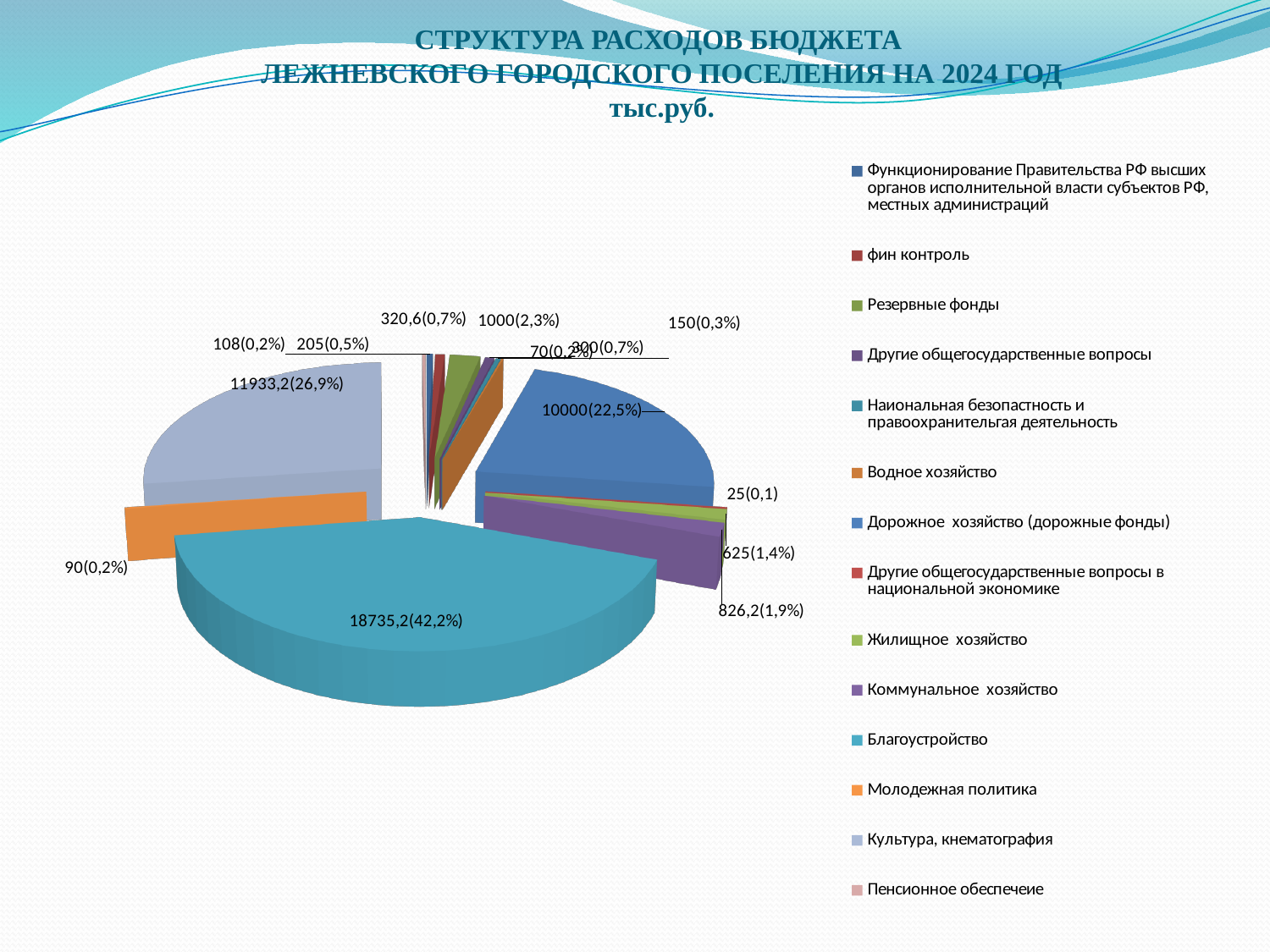
What is the smallest value labelled on the pie chart? 25(0,1) Which is larger: the slice for Культура, кнематография or the slice for Дорожное хозяйство (дорожные фонды)? Культура, кнематография Which category has the largest slice of the pie? Благоустройство What value is shown for Дорожное хозяйство (дорожные фонды)? 10000(22,5%) What is the value shown for the largest slice (Благоустройство)? 18735,2(42,2%) What value is shown for Культура, кнематография? 11933,2(26,9%) What is the difference between the Благоустройство value (18735,2) and the Культура, кнематография value (11933,2)? 6802 What kind of chart is shown on the slide? pie chart What share of the pie does Благоустройство take? 42,2% How many entries does the legend list? 14 What unit is stated in the chart title? тыс.руб. How many slices does the pie chart have? 14